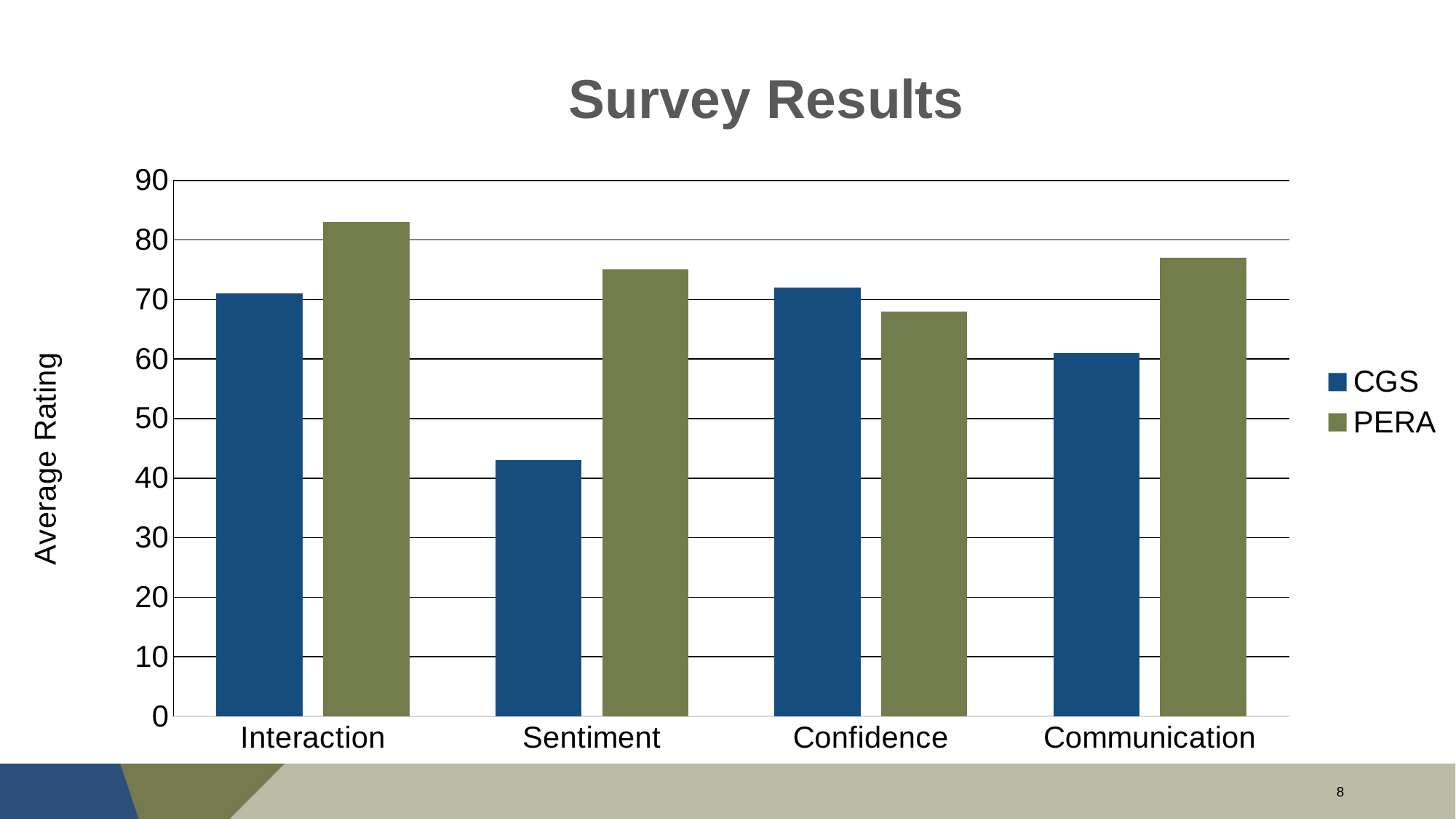
What is the title of the chart? Survey Results What is the y-axis label of the chart? Average Rating What kind of chart is shown on the slide? bar chart Which category has the lowest PERA value? Confidence How many series does the legend list? 2 Which category has the highest PERA value? Interaction For Confidence, which series has the larger value, CGS or PERA? CGS How many categories are shown on the x axis? 4 Is the PERA value for Interaction greater or less than 80? greater For Sentiment, which series has the larger value, CGS or PERA? PERA Which category has the lowest CGS value? Sentiment Is the CGS value for Sentiment greater or less than 50? less